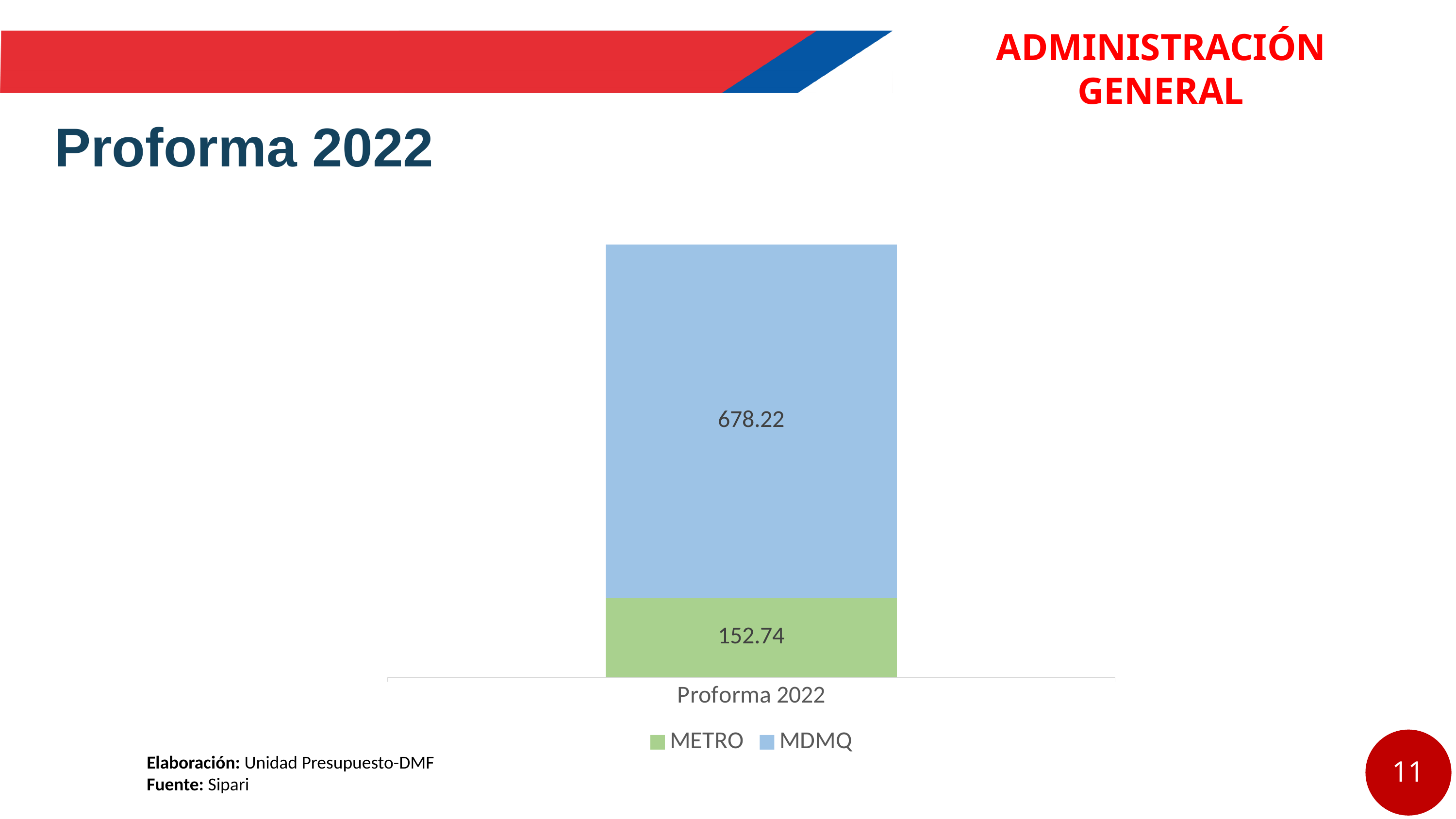
Which series has the smallest value in the chart? METRO How many categories are shown on the x axis? 1 What is the value for MDMQ in the Proforma 2022 bar? 678.22 Which series has the largest value in the chart? MDMQ How many series does the legend list? 2 Which series has the larger value in the Proforma 2022 bar, METRO or MDMQ? MDMQ What is the category label on the x axis of the chart? Proforma 2022 What kind of chart is shown on the slide? Stacked bar chart What is the value for METRO in the Proforma 2022 bar? 152.74 Which series is shown in green in the chart? METRO What is the difference between the MDMQ value and the METRO value? 525.48 What is the total of the stacked Proforma 2022 bar? 830.96